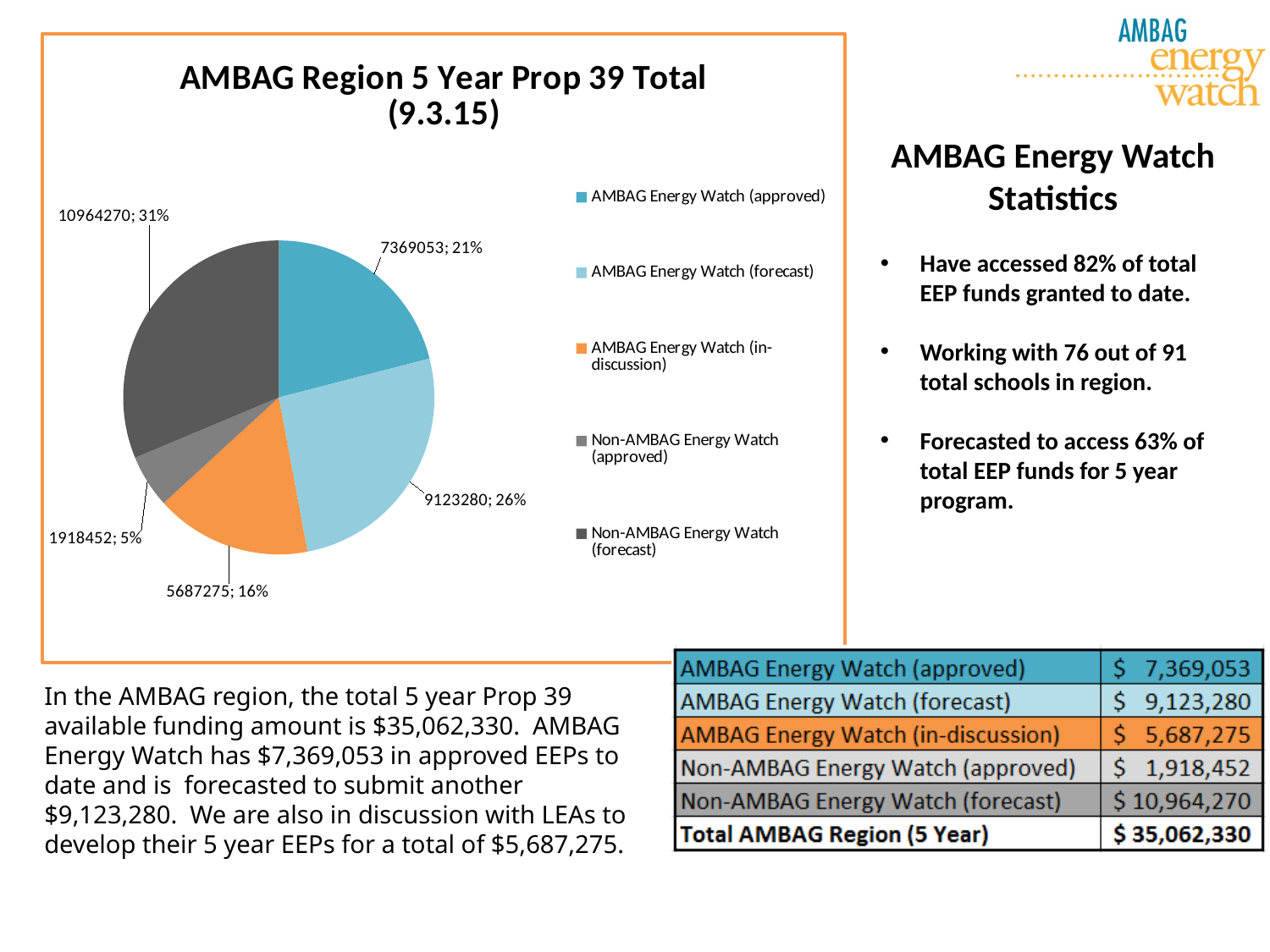
What value is shown for the AMBAG Energy Watch (forecast) slice? 9123280 What is the title of the chart? AMBAG Region 5 Year Prop 39 Total (9.3.15) What percentage share does the Non-AMBAG Energy Watch (approved) slice represent? 5% How many entries does the chart legend list? 5 What value is shown for the AMBAG Energy Watch (approved) slice? 7369053 What value is shown for the AMBAG Energy Watch (in-discussion) slice? 5687275 What percentage share does the Non-AMBAG Energy Watch (forecast) slice represent? 31% What type of chart is shown on the slide? Pie chart Which slice of the pie chart is the largest? Non-AMBAG Energy Watch (forecast) Which slice of the pie chart is the smallest? Non-AMBAG Energy Watch (approved) What is the difference between the AMBAG Energy Watch (forecast) value and the AMBAG Energy Watch (approved) value? 1754227 How many slices does the pie chart have? 5